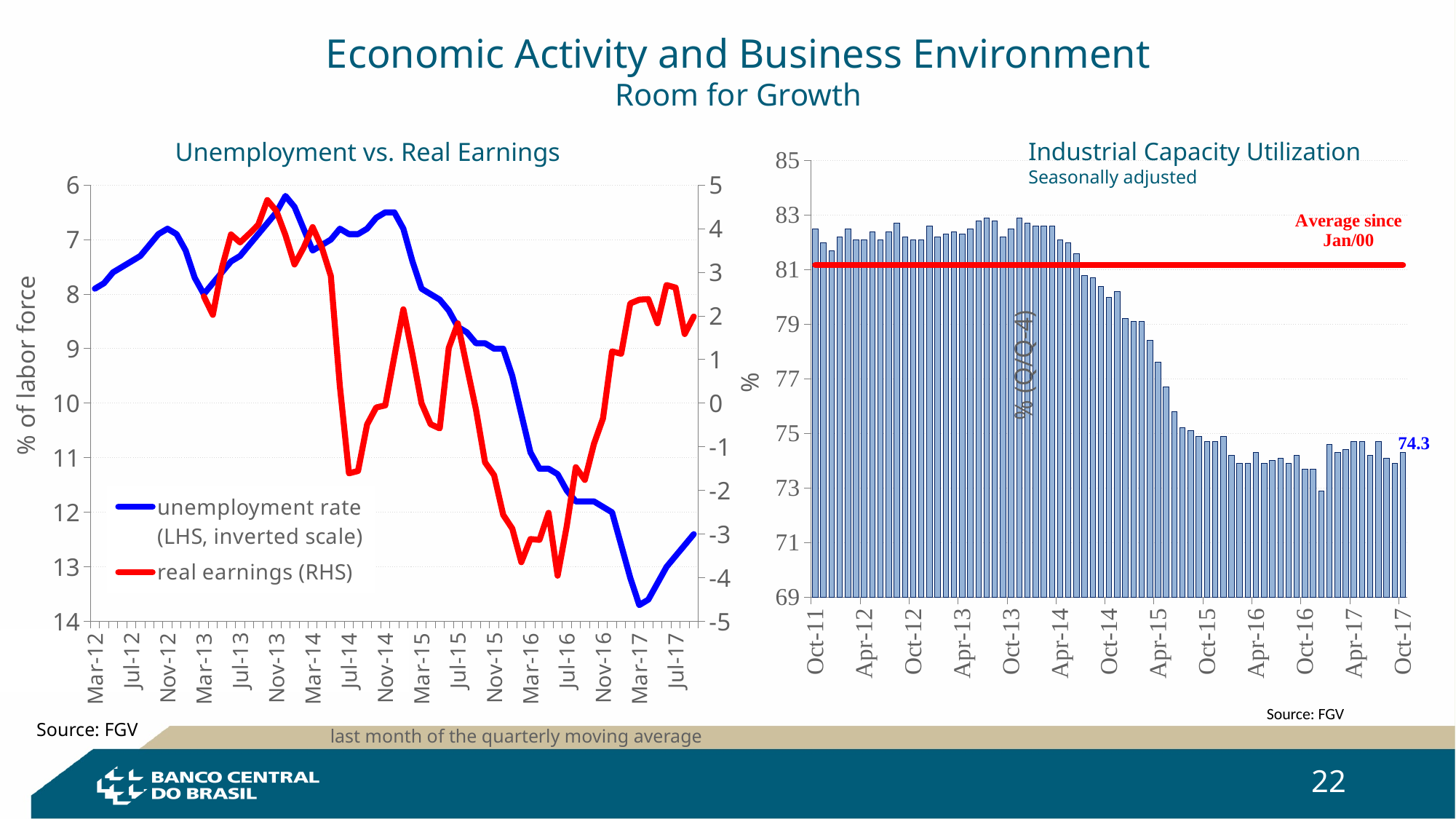
In the "Industrial Capacity Utilization" chart, what is the value labelled for Oct-17? 74.3 What is the label of the left vertical axis of the "Unemployment vs. Real Earnings" chart? % of labor force In the "Industrial Capacity Utilization" chart, do the values overall rise or fall from Oct-11 to Oct-17? fall In the "Industrial Capacity Utilization" chart, is the value for Apr-16 greater or less than 75? less In the "Industrial Capacity Utilization" chart, which bar is higher, Oct-11 or Oct-17? Oct-11 In the "Unemployment vs. Real Earnings" chart, is the unemployment rate at Mar-17 greater or less than 13? greater What kind of chart is the "Industrial Capacity Utilization" chart? bar chart How many series does the legend of the "Unemployment vs. Real Earnings" chart list? 2 In the "Unemployment vs. Real Earnings" chart, is real earnings at Jul-14 greater or less than 0? less What kind of chart is the "Unemployment vs. Real Earnings" chart? line chart In the "Industrial Capacity Utilization" chart, what does the red horizontal line represent? Average since Jan/00